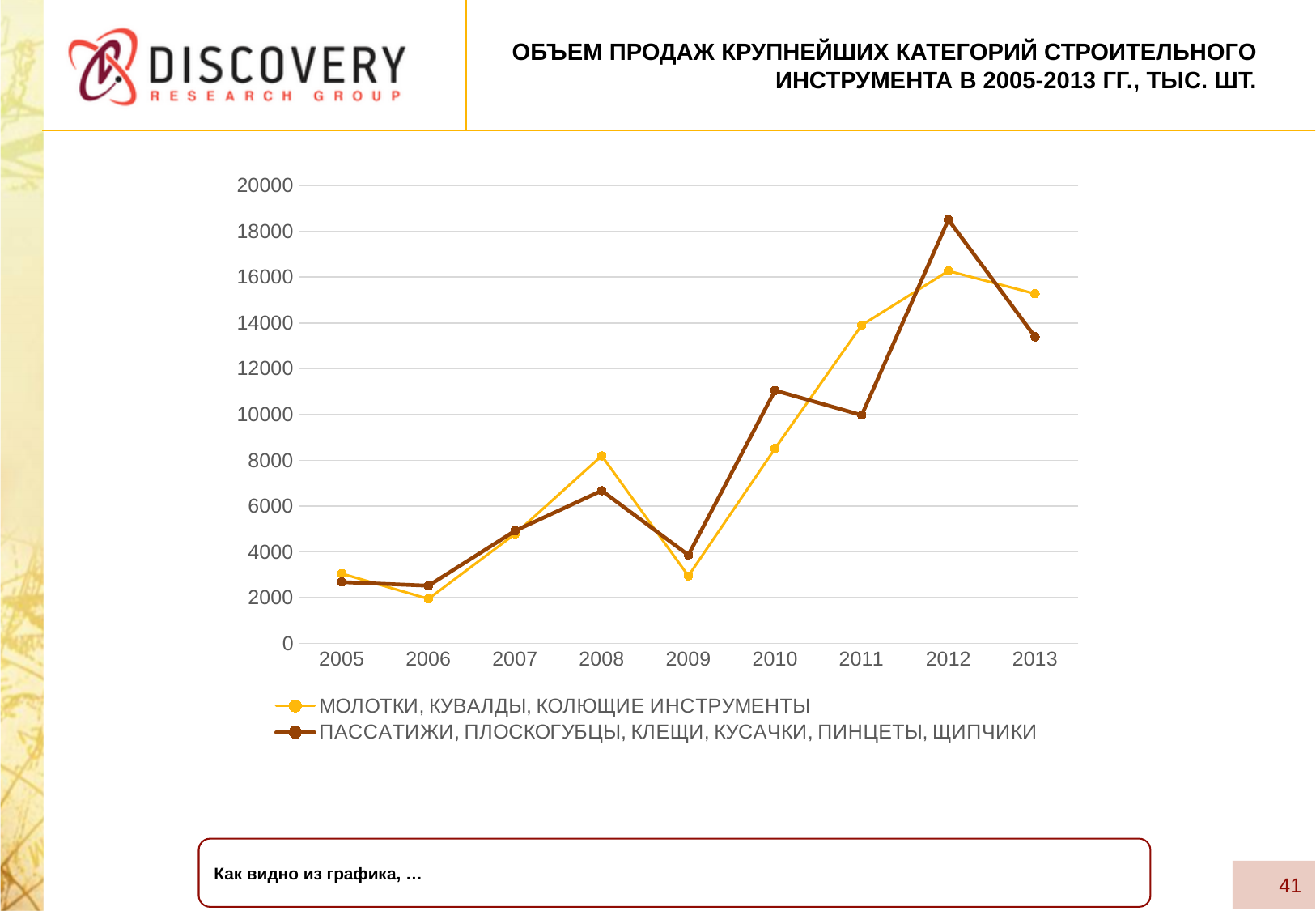
Which series has the larger value in 2011? МОЛОТКИ, КУВАЛДЫ, КОЛЮЩИЕ ИНСТРУМЕНТЫ What kind of chart is shown on the slide? line chart In which year does the series МОЛОТКИ, КУВАЛДЫ, КОЛЮЩИЕ ИНСТРУМЕНТЫ have its lowest value? 2006 In which year does the series ПАССАТИЖИ, ПЛОСКОГУБЦЫ, КЛЕЩИ, КУСАЧКИ, ПИНЦЕТЫ, ЩИПЧИКИ reach its highest value? 2012 Which series has the larger value in 2012? ПАССАТИЖИ, ПЛОСКОГУБЦЫ, КЛЕЩИ, КУСАЧКИ, ПИНЦЕТЫ, ЩИПЧИКИ How many series does the legend list? 2 In which year does the series МОЛОТКИ, КУВАЛДЫ, КОЛЮЩИЕ ИНСТРУМЕНТЫ reach its highest value? 2012 How many years are plotted along the x axis? 9 Do the values of the series МОЛОТКИ, КУВАЛДЫ, КОЛЮЩИЕ ИНСТРУМЕНТЫ rise or fall from 2012 to 2013? fall What is the unit of measurement stated in the chart title? тыс. шт. Is the value for ПАССАТИЖИ, ПЛОСКОГУБЦЫ, КЛЕЩИ, КУСАЧКИ, ПИНЦЕТЫ, ЩИПЧИКИ in 2012 greater or less than 18000? greater Is the value for МОЛОТКИ, КУВАЛДЫ, КОЛЮЩИЕ ИНСТРУМЕНТЫ in 2009 greater or less than 4000? less